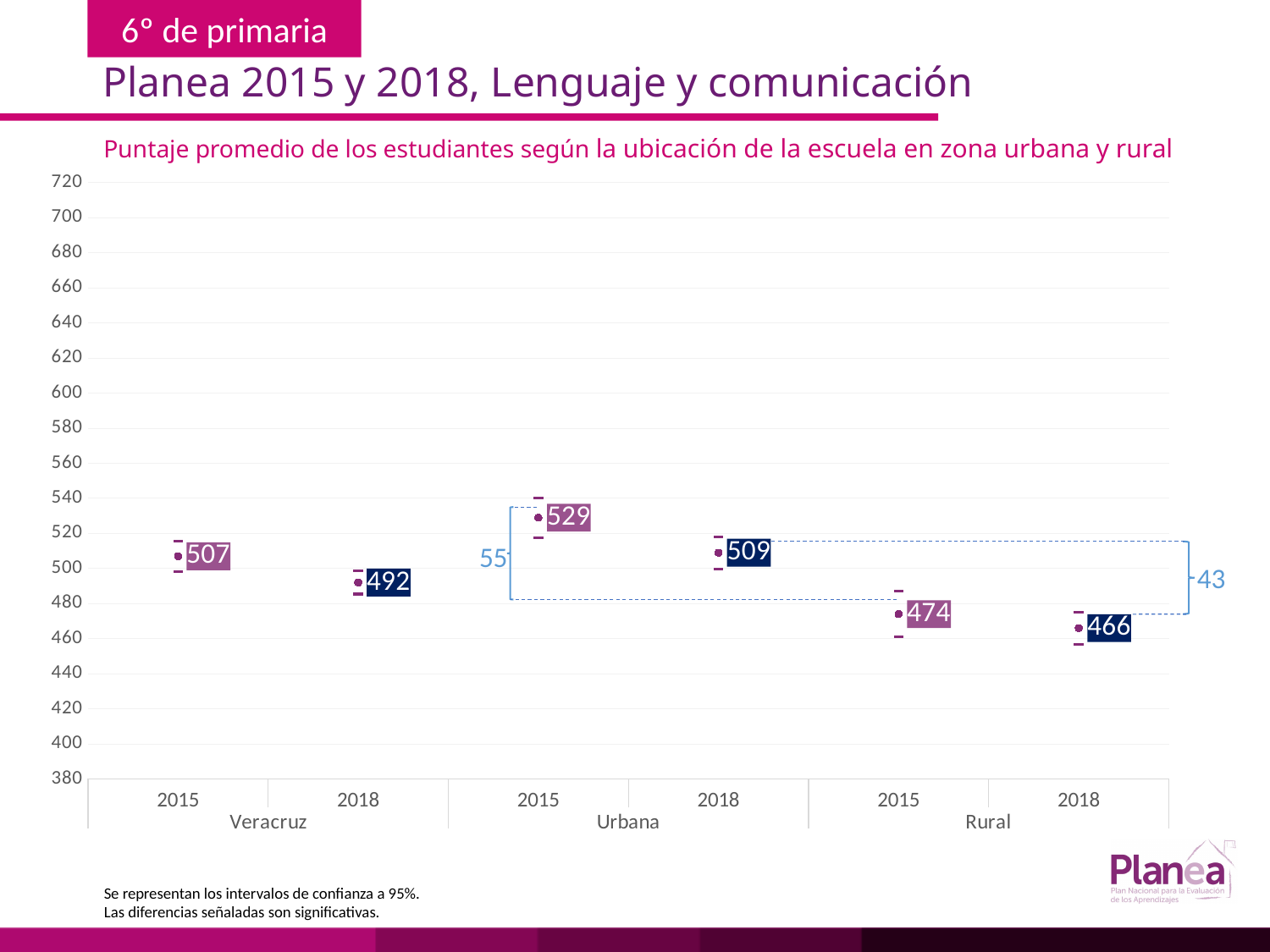
Which group and year has the lowest average score? Rural 2018 What is the average score for Veracruz in 2015? 507 What is the title of the chart? Puntaje promedio de los estudiantes según la ubicación de la escuela en zona urbana y rural What is the difference between the Veracruz scores in 2015 and 2018? 15 What is the average score for Rural in 2018? 466 What is the difference between the Urbana and Rural scores in 2015? 55 What is the average score for Urbana in 2018? 509 Which is larger, the Veracruz score in 2018 or the Rural score in 2015? Veracruz 2018 Do the scores rise or fall from 2015 to 2018 for each of the three groups? fall What is the difference between the Urbana and Rural scores in 2018? 43 Which group and year has the highest average score? Urbana 2015 How many data points are plotted on the chart? 6